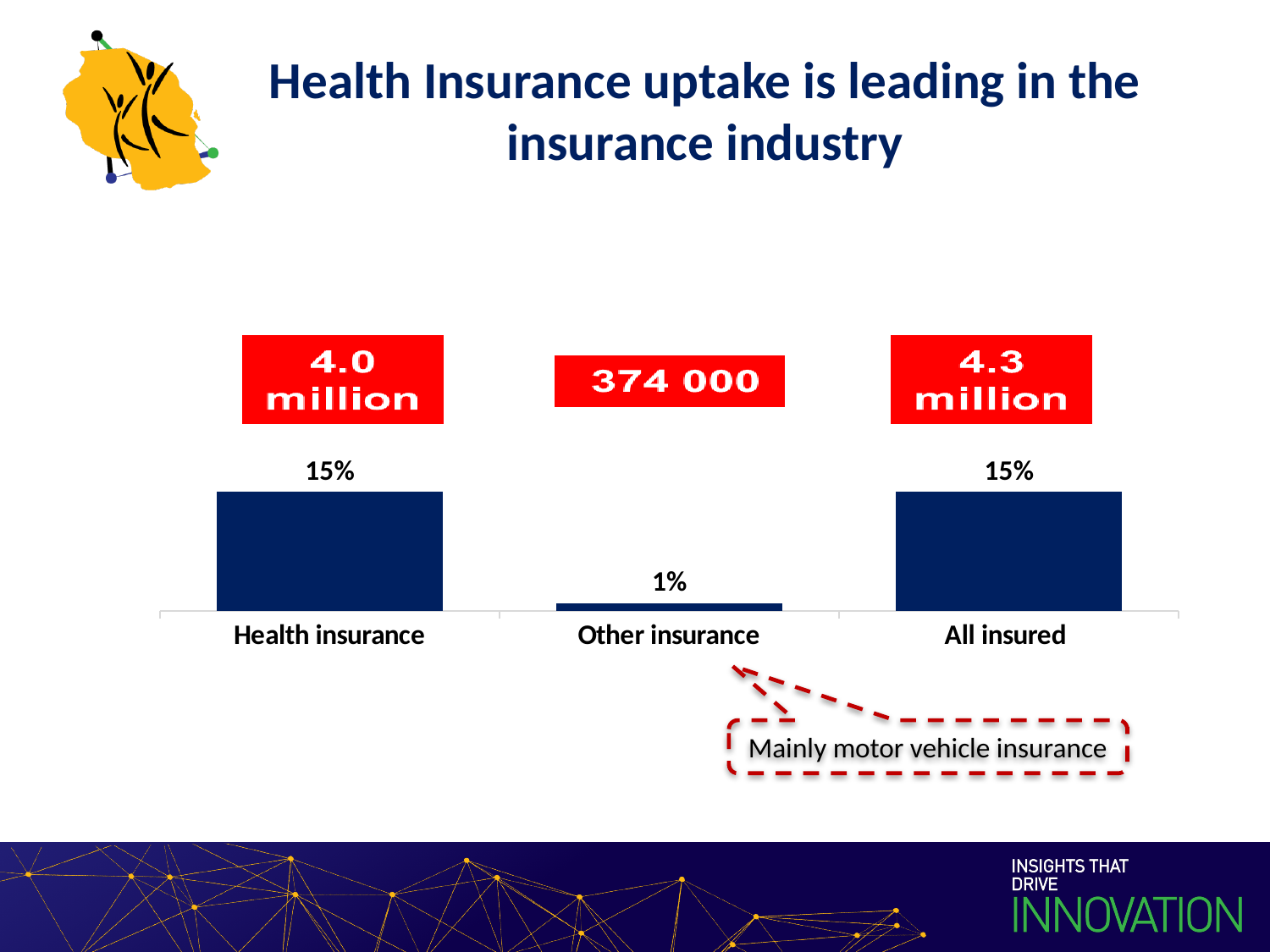
What number of people is shown in the red box above the Health insurance bar? 4.0 million What is the difference in percentage points between Health insurance and Other insurance? 14 What percentage is shown for Other insurance? 1% What percentage is shown for Health insurance? 15% What number of people is shown in the red box above the Other insurance bar? 374 000 What number of people is shown in the red box above the All insured bar? 4.3 million According to the annotation, what does Other insurance mainly consist of? Mainly motor vehicle insurance How many categories are shown on the x axis? 3 What kind of chart is shown on the slide? Bar chart Which category has the lowest percentage? Other insurance What percentage is shown for All insured? 15% Which is larger, the percentage for Health insurance or for Other insurance? Health insurance